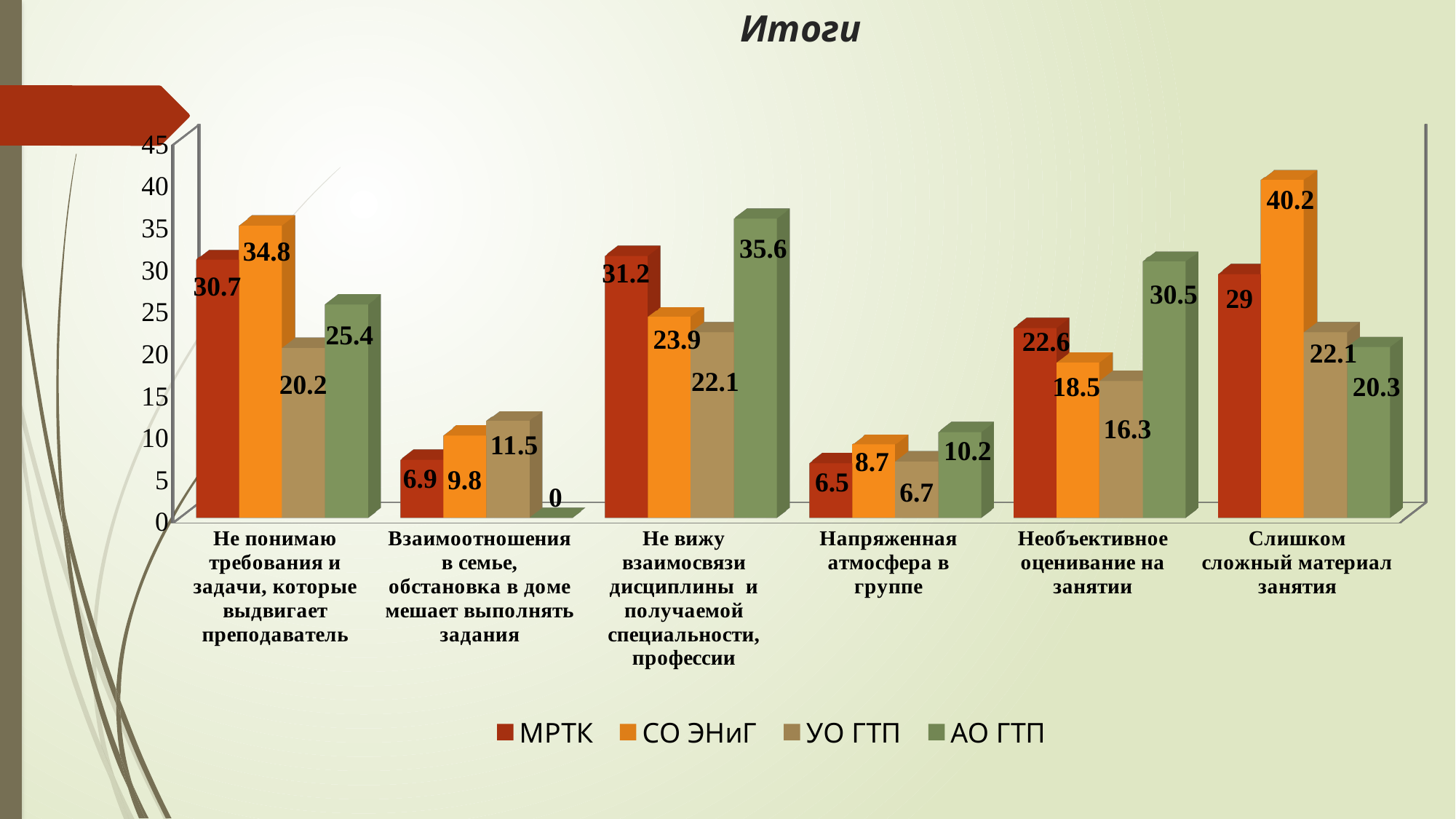
Which series has the highest value in the category "Слишком сложный материал занятия"? СО ЭНиГ What type of chart is shown on the slide? Bar chart Which is larger in the category "Необъективное оценивание на занятии": the value for МРТК or the value for АО ГТП? АО ГТП What is the value for СО ЭНиГ in the category "Слишком сложный материал занятия"? 40.2 Is the value for АО ГТП in the category "Напряженная атмосфера в группе" greater or less than 15? less Which series has the lowest value in the category "Взаимоотношения в семье, обстановка в доме мешает выполнять задания"? АО ГТП What is the value for УО ГТП in the category "Необъективное оценивание на занятии"? 16.3 What is the difference between the СО ЭНиГ and МРТК values in the category "Не понимаю требования и задачи, которые выдвигает преподаватель"? 4.1 How many series does the legend list? 4 What is the value for МРТК in the category "Напряженная атмосфера в группе"? 6.5 How many categories are shown on the x axis of the chart? 6 What is the value for АО ГТП in the category "Не вижу взаимосвязи дисциплины и получаемой специальности, профессии"? 35.6